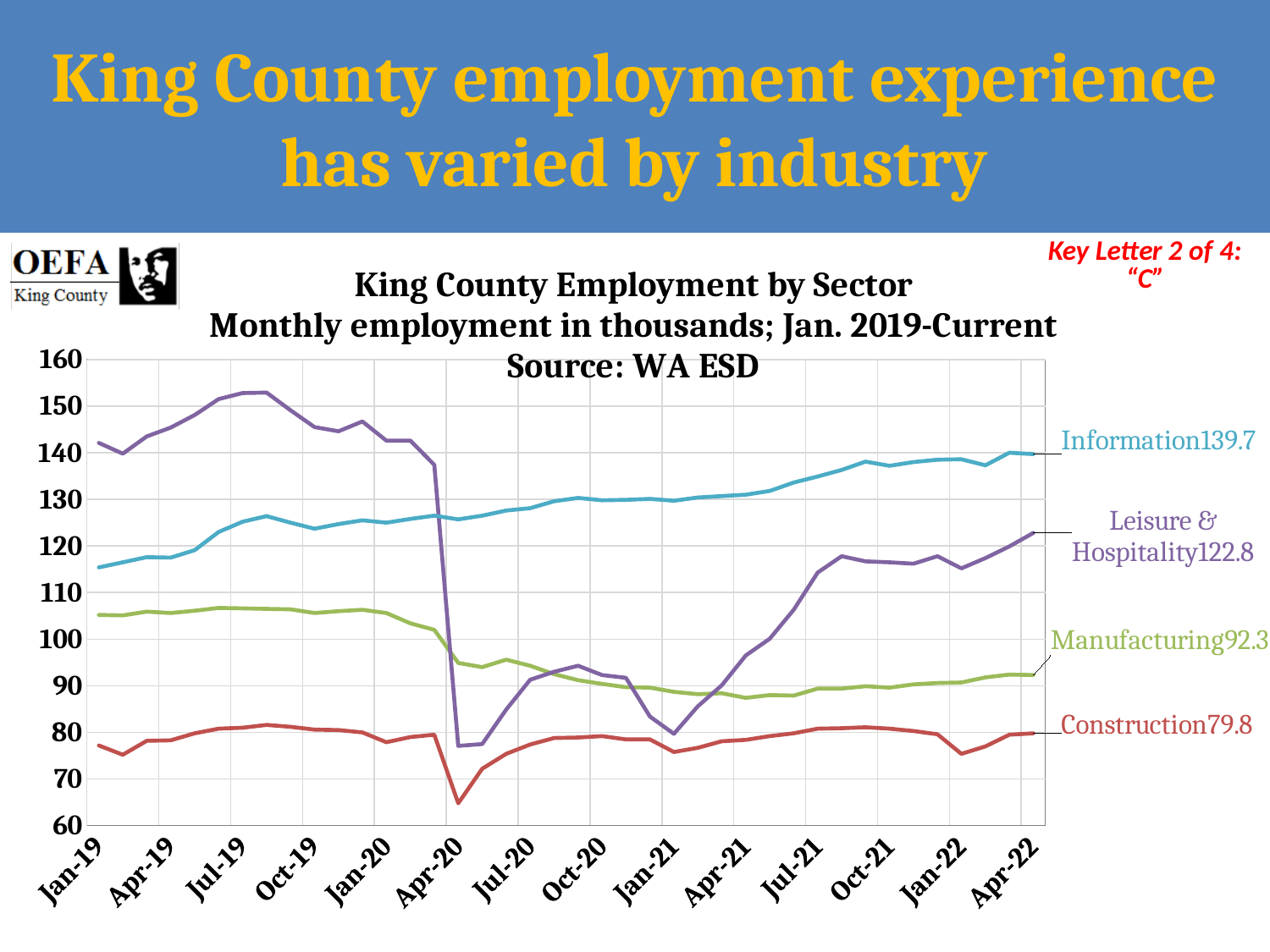
What is the latest value shown for the Manufacturing series? 92.3 Is the value for Leisure & Hospitality at its peak around Jul-19 greater or less than 150? greater Is the value for Construction at its lowest point around Apr-20 greater or less than 70? less How many sectors (series) are plotted on the chart? 4 What is the latest value shown for the Leisure & Hospitality series? 122.8 What is the latest value shown for the Construction series? 79.8 What is the latest value shown for the Information series? 139.7 Which sector has the lowest employment at the end of the series (Apr-22)? Construction At the end of the series, which is larger: Manufacturing or Construction? Manufacturing What is the difference between the latest Information value and the latest Leisure & Hospitality value? 16.9 What kind of chart is shown on the slide? Line chart Which sector has the highest employment at the end of the series (Apr-22)? Information